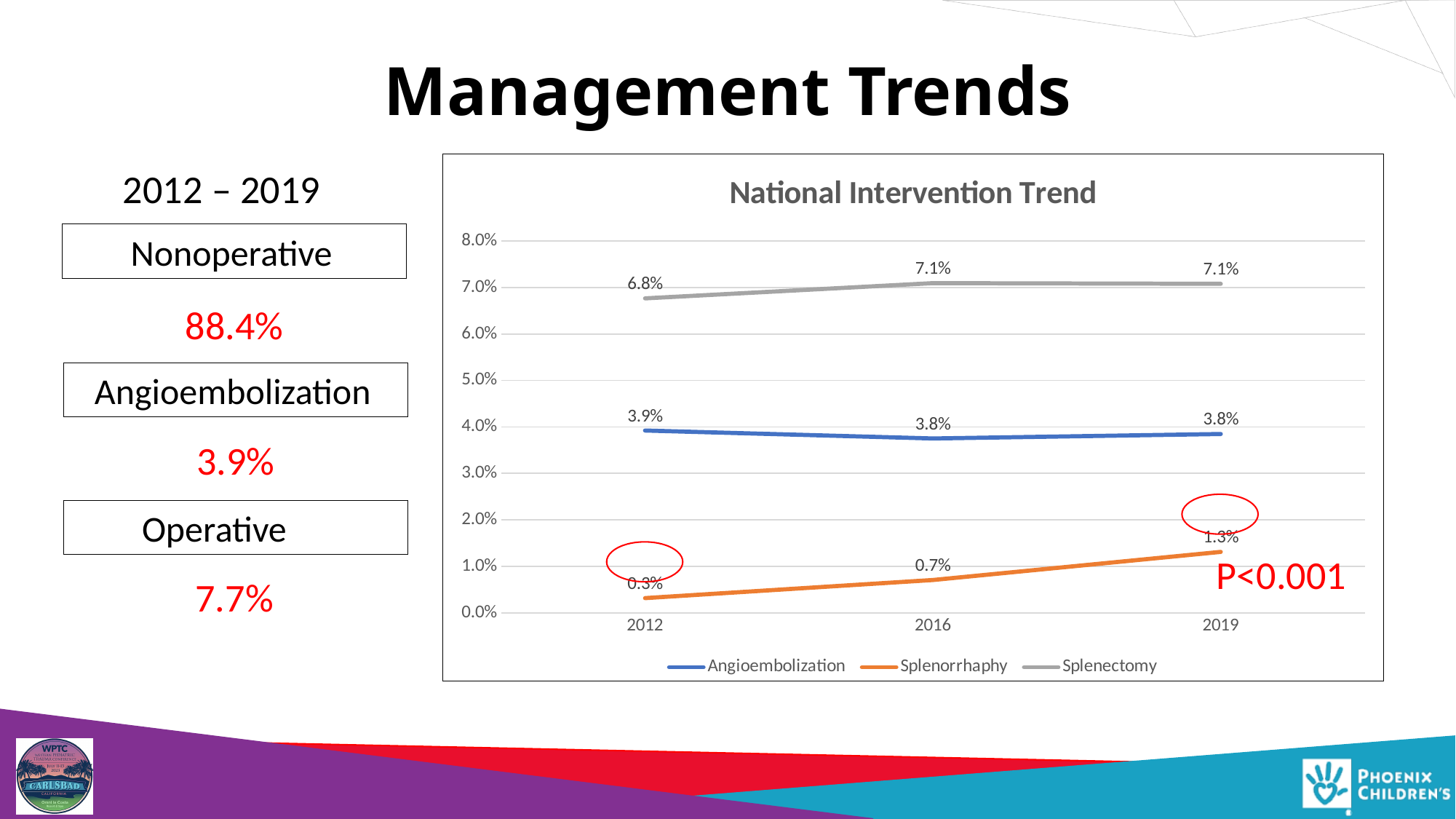
How many series does the legend list? 3 Does the Splenorrhaphy series rise or fall from 2012 to 2019? Rise What is the Splenorrhaphy value in 2019? 1.3% What is the Splenectomy value in 2012? 6.8% What kind of chart is shown? Line chart What is the Angioembolization value in 2016? 3.8% What is the title of the chart? National Intervention Trend What is the difference between the Splenectomy and Angioembolization values in 2016? 3.3% Which is larger in 2019: Angioembolization or Splenorrhaphy? Angioembolization Which series has the lowest value in 2012? Splenorrhaphy Which series has the highest value in 2019? Splenectomy How many years are shown on the x axis? 3